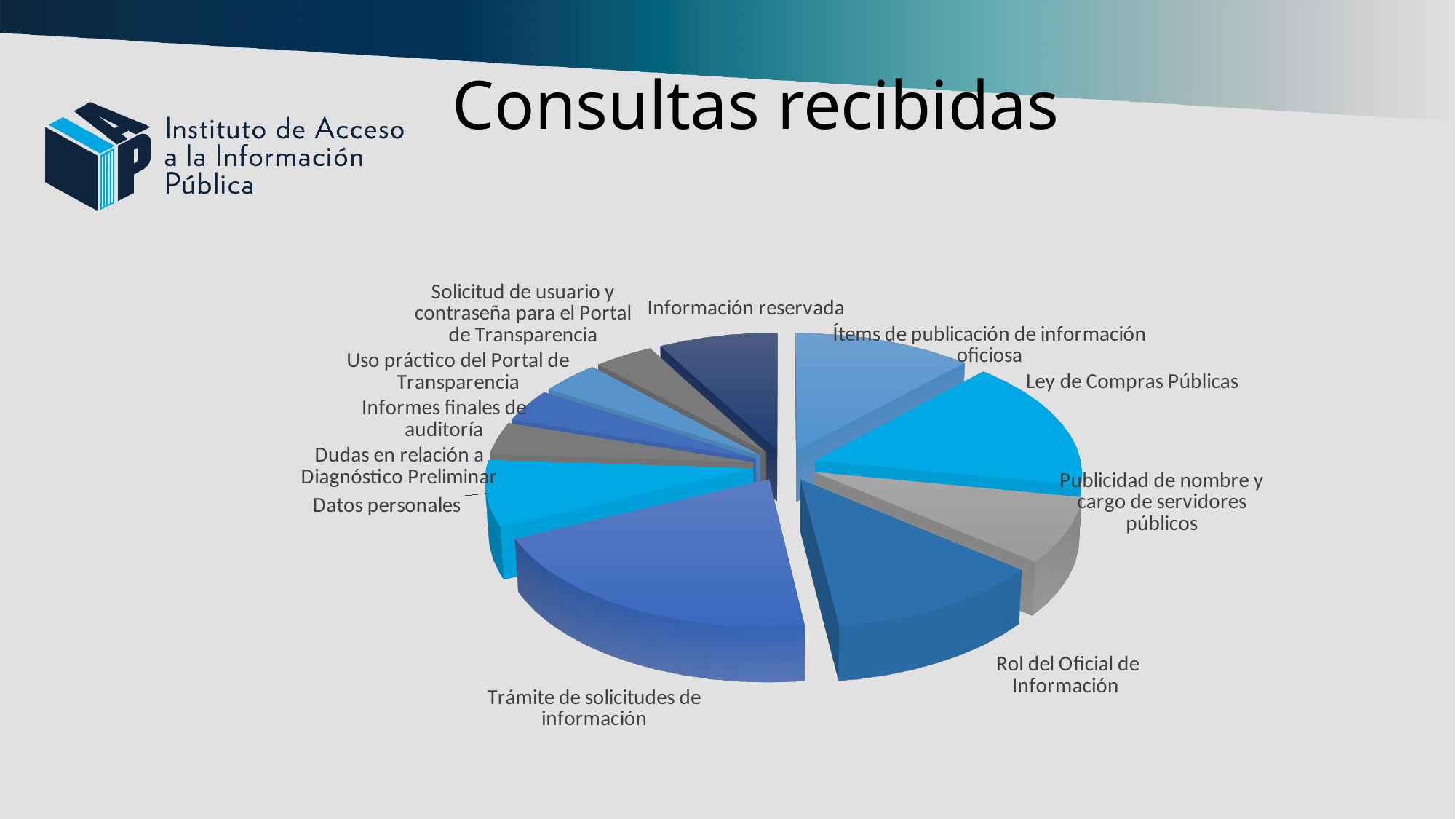
Which slice is larger: Ítems de publicación de información oficiosa or Informes finales de auditoría? Ítems de publicación de información oficiosa Which slice is larger: Ley de Compras Públicas or Solicitud de usuario y contraseña para el Portal de Transparencia? Ley de Compras Públicas Which category has the largest slice of the pie? Trámite de solicitudes de información Which slice is larger: Rol del Oficial de Información or Uso práctico del Portal de Transparencia? Rol del Oficial de Información What is the title of the chart? Consultas recibidas How many categories (slices) does the pie chart have? 11 Does the pie chart display numeric data labels on its slices? No What kind of chart is shown on the slide? pie chart